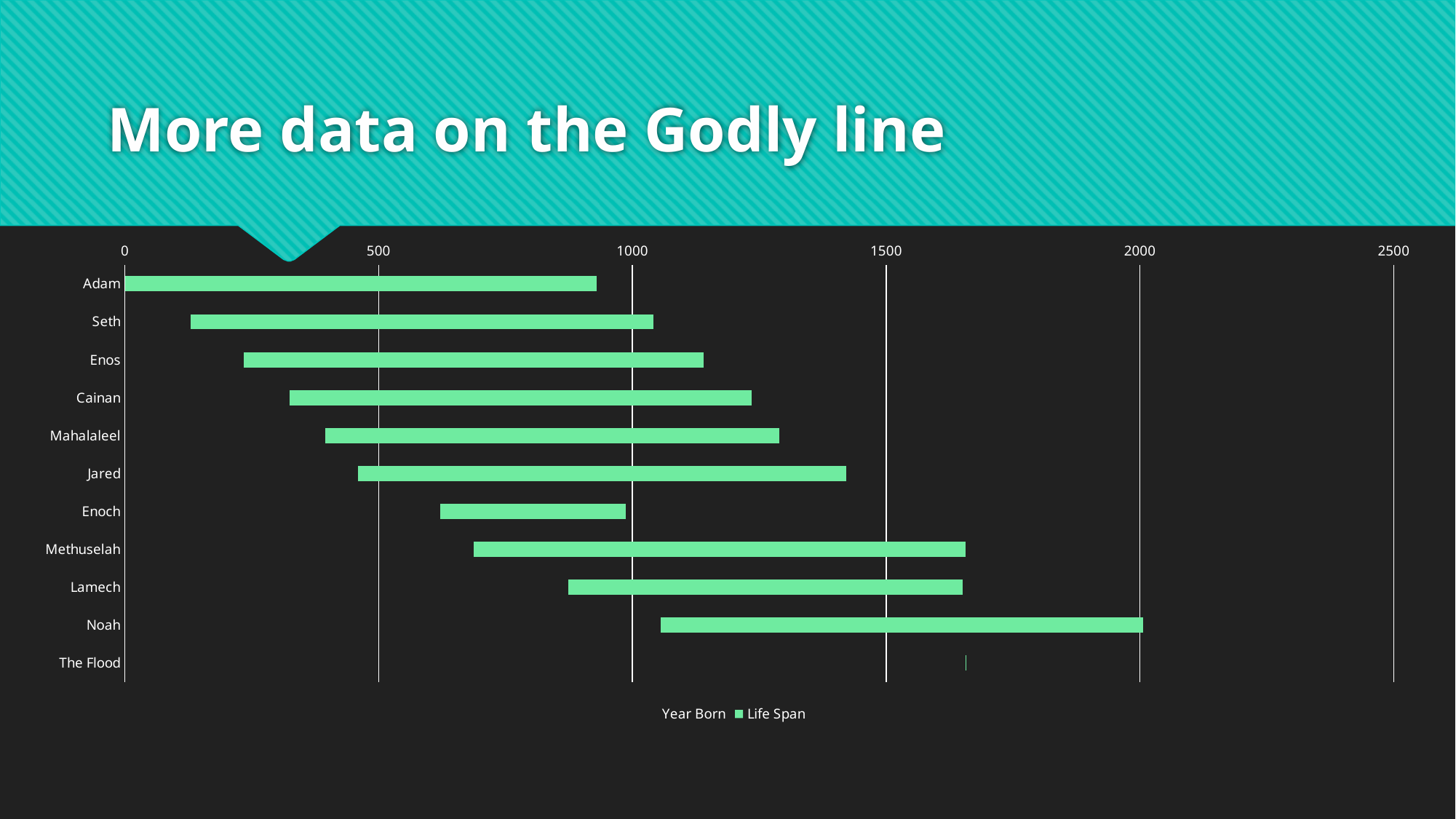
Which has the longer green bar, Enoch or Noah? Noah Is the right end of Methuselah's bar greater or less than 1500? greater How many series does the chart legend list? 2 What are the two series names shown in the chart legend? Year Born and Life Span Is the left end of Lamech's bar greater or less than 1000? less What kind of chart is shown on the slide? bar chart Is the right end of Adam's bar greater or less than 1000? less What is the title of the slide containing the chart? More data on the Godly line How many categories are listed on the vertical axis of the chart? 11